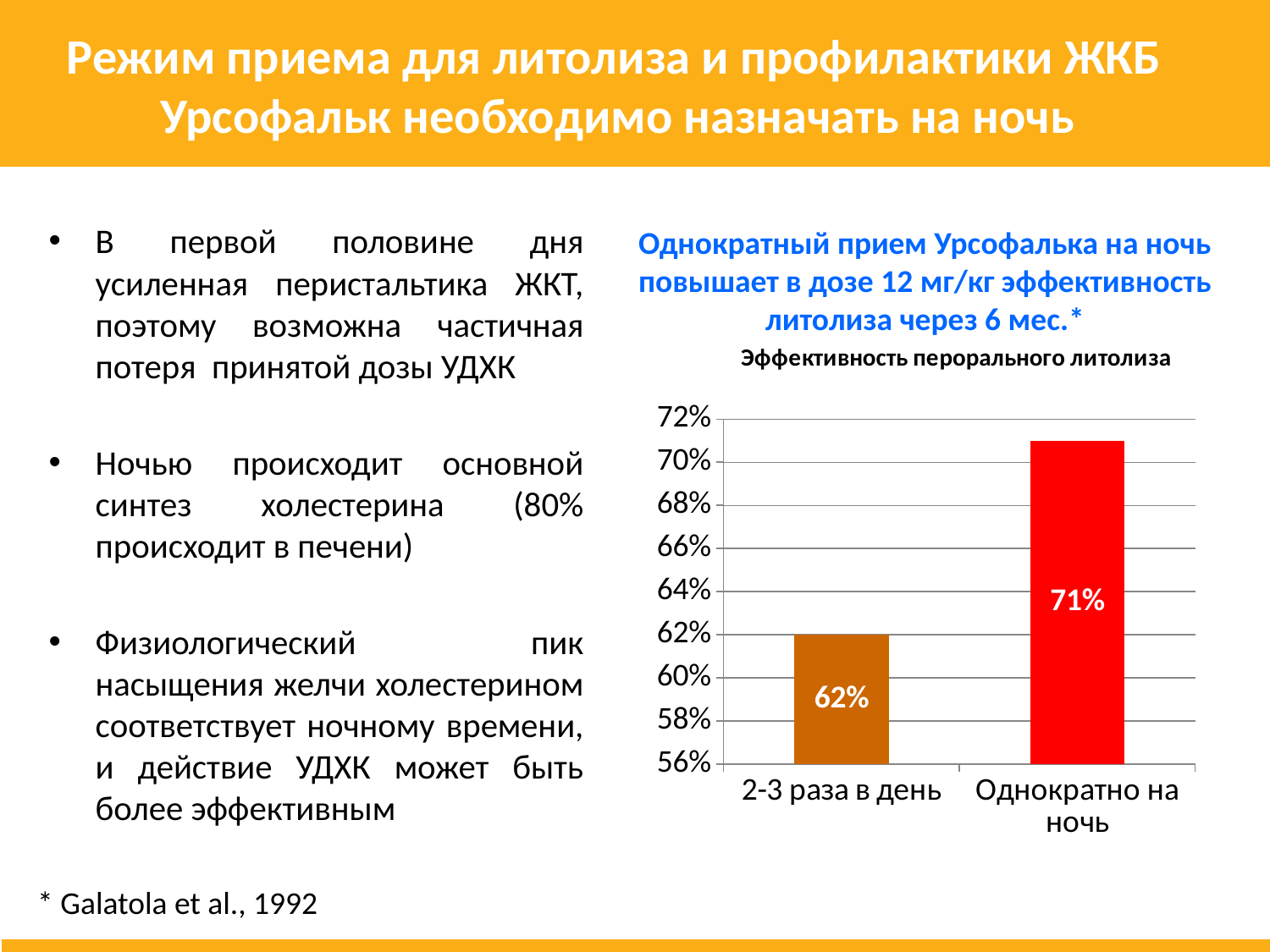
What is the title of the chart? Эффективность перорального литолиза How many categories are shown in the chart? 2 Is the value for "Однократно на ночь" greater or less than 68%? greater What kind of chart is shown on the slide? bar chart Which is larger: the value for "2-3 раза в день" or for "Однократно на ночь"? Однократно на ночь What is the value for "Однократно на ночь"? 71% Which category has the highest value? Однократно на ночь What colour is the bar for "Однократно на ночь"? red What is the value for "2-3 раза в день"? 62% What is the difference between the values for "Однократно на ночь" and "2-3 раза в день"? 9% Is the value for "2-3 раза в день" greater or less than 66%? less Which category has the lowest value? 2-3 раза в день